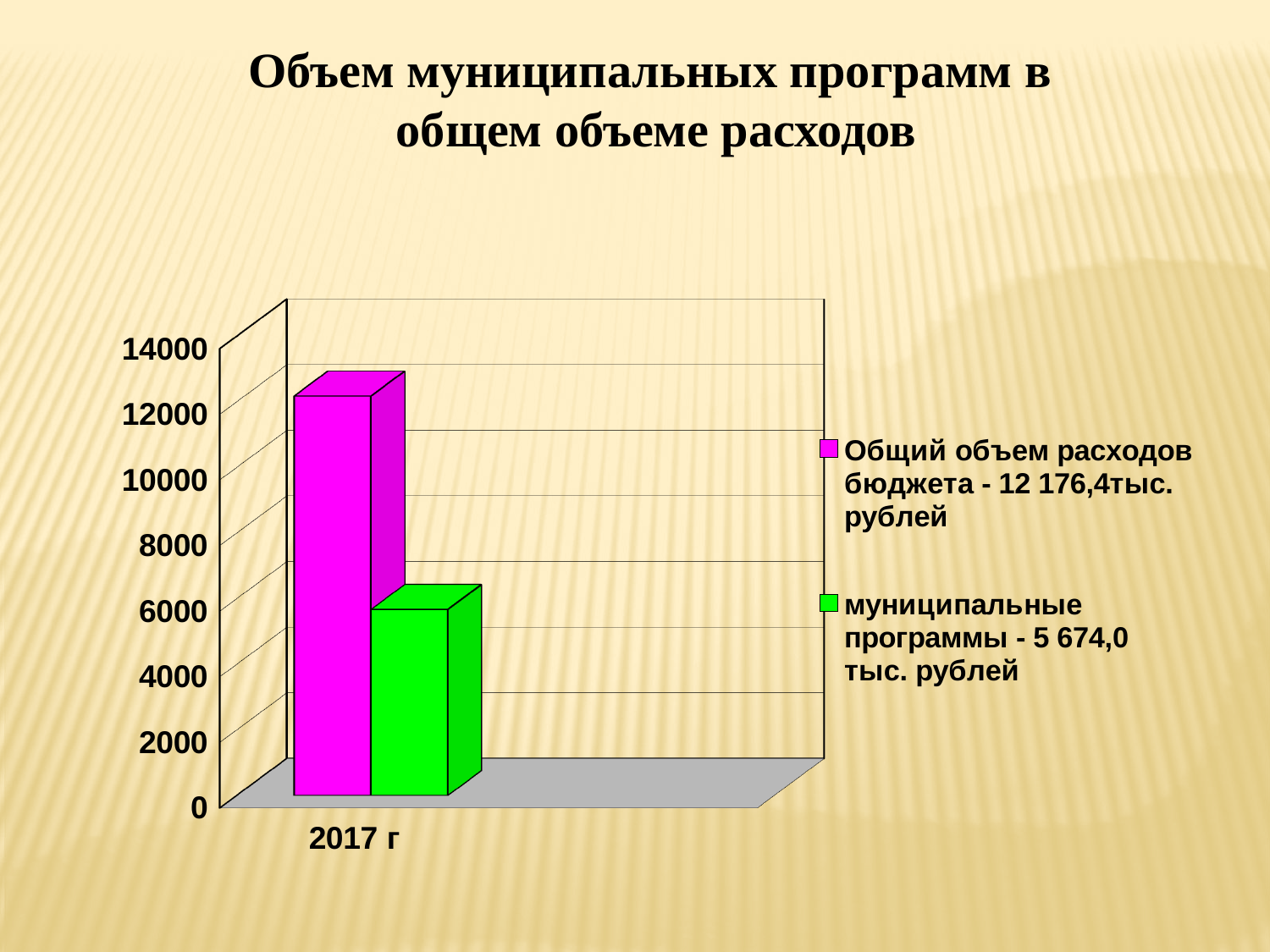
According to the legend, what is the value of 'муниципальные программы'? 5 674,0 тыс. рублей What is the title of the chart on the slide? Объем муниципальных программ в общем объеме расходов How many series does the legend list? 2 Which series has the lowest bar? муниципальные программы How many categories are shown on the x axis? 1 Which series has the higher value: 'Общий объем расходов бюджета' or 'муниципальные программы'? Общий объем расходов бюджета What kind of chart is shown on the slide? bar chart Is the value for 'Общий объем расходов бюджета' greater or less than 10000? greater Is the value for 'муниципальные программы' greater or less than 8000? less Which year is shown on the x axis? 2017 г What is the difference between 'Общий объем расходов бюджета' and 'муниципальные программы'? 6 502,4 тыс. рублей According to the legend, what is the value of 'Общий объем расходов бюджета'? 12 176,4 тыс. рублей